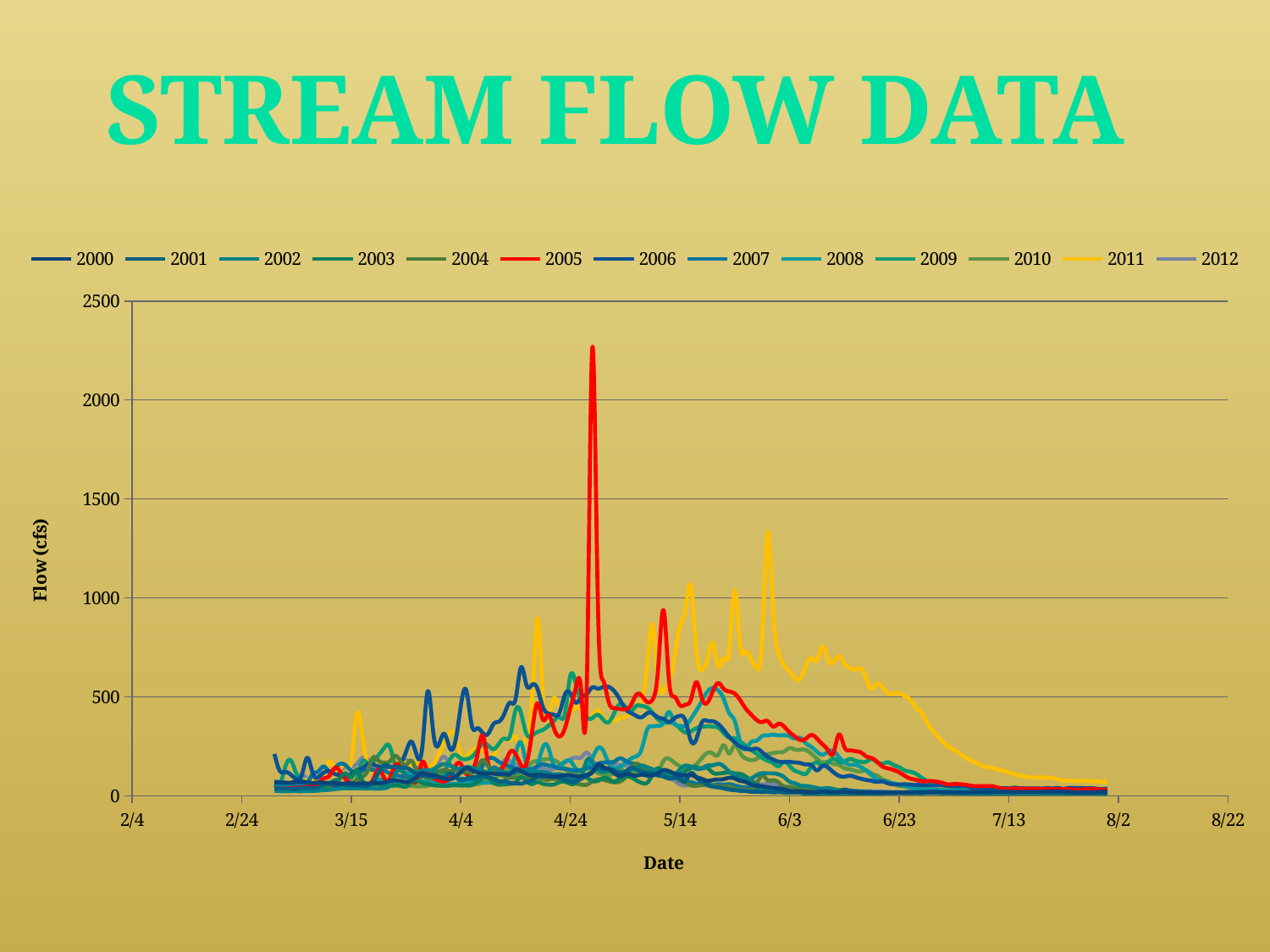
What kind of chart is shown on the slide? line chart Is the peak value of the 2011 series greater or less than 1000? greater What is the highest value shown on the vertical axis? 2500 Is the peak value of the 2005 series greater or less than 2000? greater Do the flow values for the 2011 series rise or fall between 6/23 and 7/13? fall What is the label of the vertical axis? Flow (cfs) What is the title of the slide's chart? STREAM FLOW DATA How many series does the legend list? 13 Is the peak value of the 2011 series greater or less than 1500? less Which series reaches the highest peak flow on the chart? 2005 Which series has the higher peak, 2005 or 2011? 2005